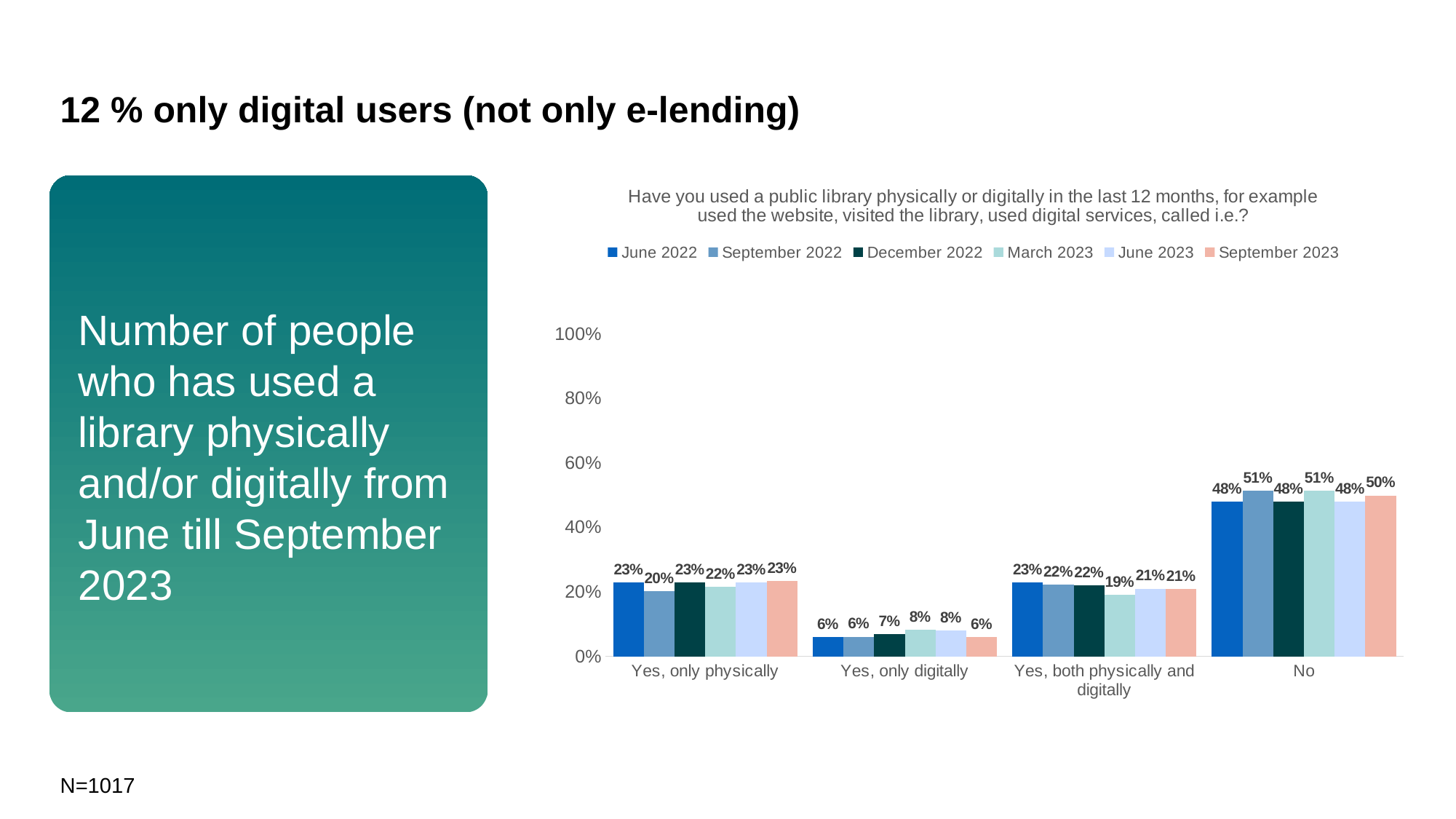
What is the value for "Yes, only physically" in September 2022? 20% What percentage answered "Yes, only digitally" in September 2023? 6% What is the difference between the "No" values for September 2022 and June 2022? 3% Which response category has the lowest values across all survey waves? Yes, only digitally Is the value for "No" in September 2023 greater or less than 40%? greater How many response categories are shown on the x axis? 4 How many series does the legend list? 6 What percentage answered "Yes, both physically and digitally" in March 2023? 19% What is the value for "No" in September 2022? 51% Which is larger for "Yes, both physically and digitally": June 2022 or March 2023? June 2022 Which response category has the highest values across all survey waves? No What kind of chart is shown on the slide? Bar chart